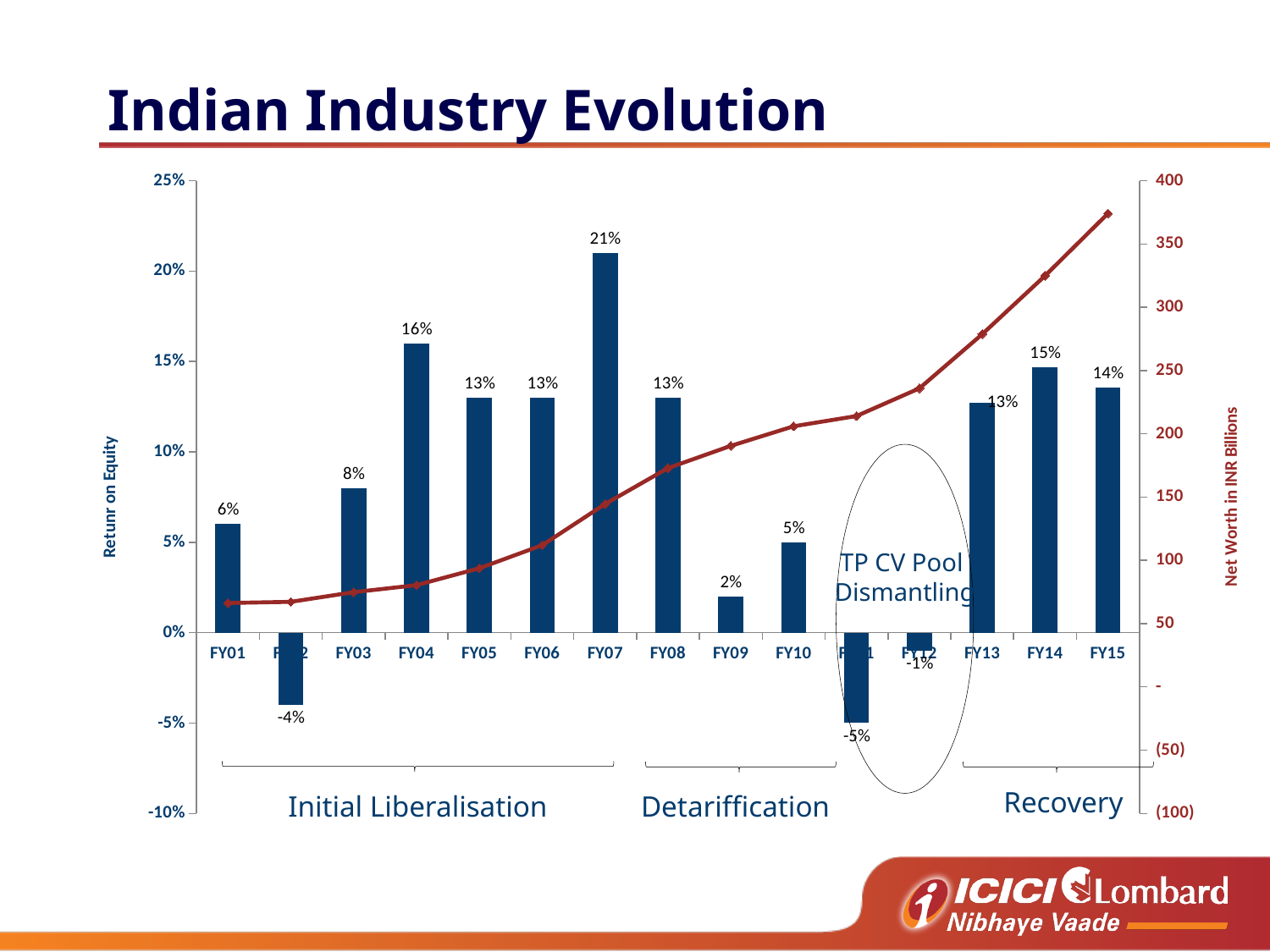
What kind of chart is shown on the slide? Combination bar and line chart Which fiscal year has the highest Return on Equity? FY07 What is the Return on Equity for FY02? -4% What is the Return on Equity for FY07? 21% What is the difference in Return on Equity between FY07 and FY04? 5 percentage points Does the Net Worth line rise or fall from FY01 to FY15? Rises What is the Return on Equity for FY11? -5% Which year has a higher Return on Equity, FY04 or FY14? FY04 How many fiscal years are shown on the x axis? 15 Which fiscal year has the lowest Return on Equity? FY11 Is the Net Worth in INR Billions for FY15 greater or less than 350? greater Is the Net Worth in INR Billions for FY08 greater or less than 200? less